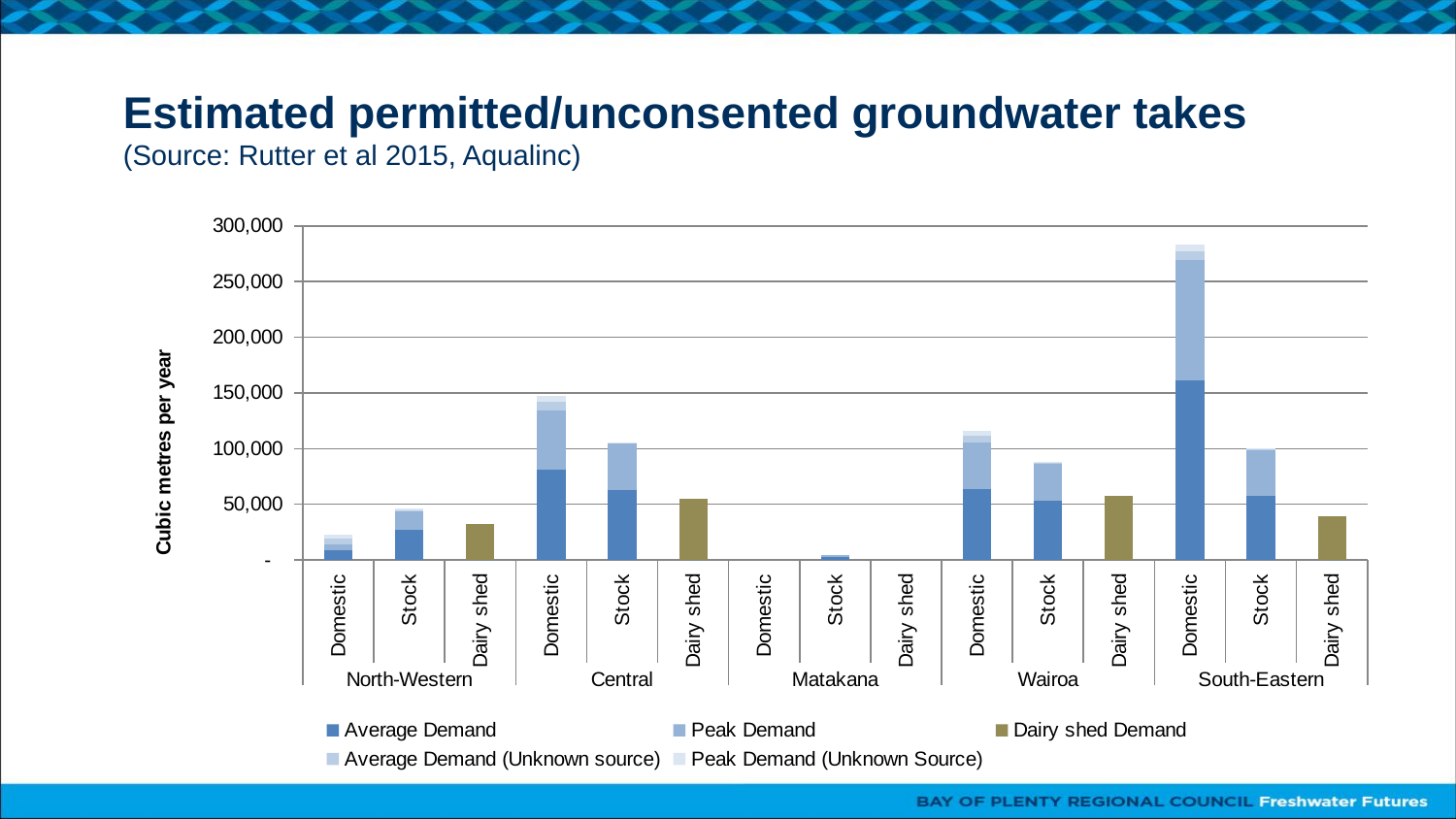
Which is larger, the Central Dairy shed bar or the North-Western Dairy shed bar? Central Dairy shed How many series does the legend list? 5 Is the total value for Central Domestic greater or less than 100,000? greater Is the value for Wairoa Dairy shed greater or less than 100,000? less Is the total value for South-Eastern Domestic greater or less than 250,000? greater Which is larger, the Wairoa Domestic bar or the Wairoa Stock bar? Wairoa Domestic How many regions are shown along the x axis? 5 What is the title of the vertical axis? Cubic metres per year What type of chart is shown on the slide? Stacked bar chart Which region has the smallest Stock bar? Matakana Which bar is the tallest in the chart? South-Eastern Domestic